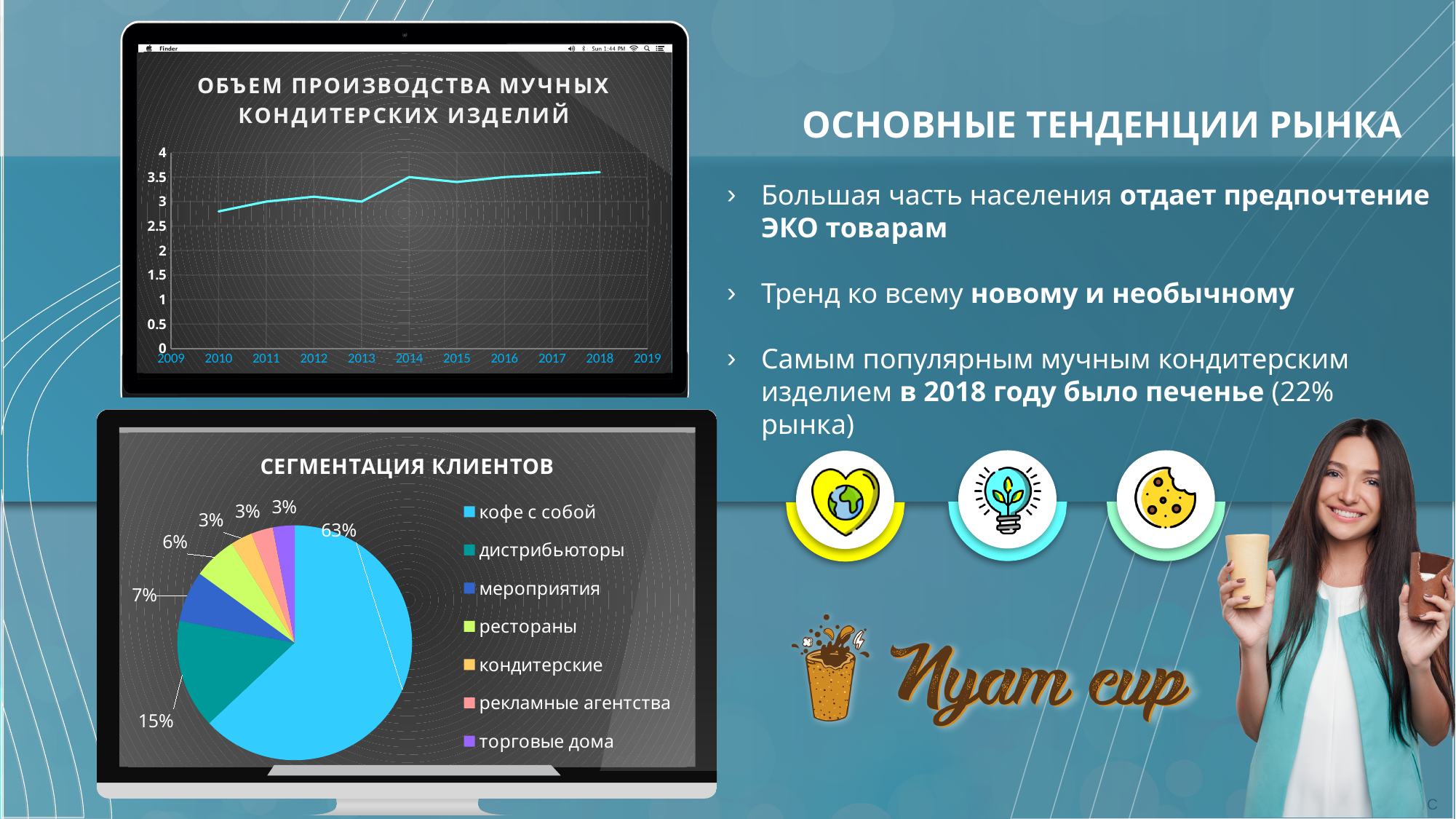
In the chart "СЕГМЕНТАЦИЯ КЛИЕНТОВ", what share does "кофе с собой" have? 63% In the chart "ОБЪЕМ ПРОИЗВОДСТВА МУЧНЫХ КОНДИТЕРСКИХ ИЗДЕЛИЙ", do the values generally rise or fall from 2010 to 2018? rise In the chart "ОБЪЕМ ПРОИЗВОДСТВА МУЧНЫХ КОНДИТЕРСКИХ ИЗДЕЛИЙ", is the value for 2018 greater or less than 3.5? greater In the chart "СЕГМЕНТАЦИЯ КЛИЕНТОВ", what is the difference between the shares of "кофе с собой" and "дистрибьюторы"? 48% How many categories does the legend of the chart "СЕГМЕНТАЦИЯ КЛИЕНТОВ" list? 7 In the chart "СЕГМЕНТАЦИЯ КЛИЕНТОВ", what is the value for "дистрибьюторы"? 15% In the chart "ОБЪЕМ ПРОИЗВОДСТВА МУЧНЫХ КОНДИТЕРСКИХ ИЗДЕЛИЙ", which year has the highest value? 2018 What kind of chart is the chart titled "СЕГМЕНТАЦИЯ КЛИЕНТОВ"? pie chart In the chart "ОБЪЕМ ПРОИЗВОДСТВА МУЧНЫХ КОНДИТЕРСКИХ ИЗДЕЛИЙ", is the value for 2010 greater or less than 3? less In the chart "ОБЪЕМ ПРОИЗВОДСТВА МУЧНЫХ КОНДИТЕРСКИХ ИЗДЕЛИЙ", which year has the lowest value? 2010 What kind of chart is the chart titled "ОБЪЕМ ПРОИЗВОДСТВА МУЧНЫХ КОНДИТЕРСКИХ ИЗДЕЛИЙ"? line chart In the chart "СЕГМЕНТАЦИЯ КЛИЕНТОВ", which category has the largest share? кофе с собой